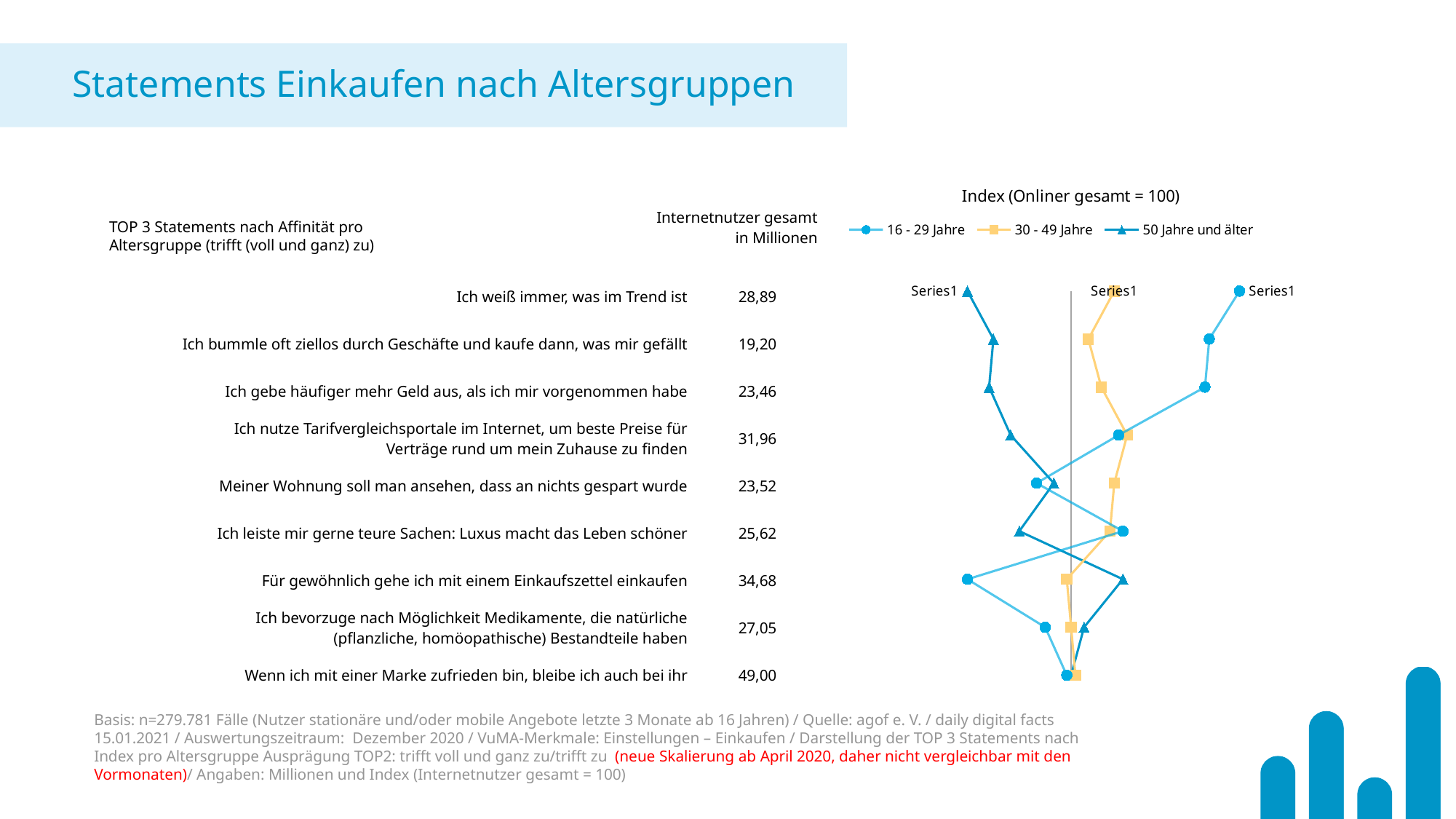
How many series does the chart legend list? 3 Which statement has the lowest value of 'Internetnutzer gesamt in Millionen'? Ich bummle oft ziellos durch Geschäfte und kaufe dann, was mir gefällt Is the index for 16 - 29 Jahre for 'Ich weiß immer, was im Trend ist' greater or less than 100? greater For 'Ich bummle oft ziellos durch Geschäfte und kaufe dann, was mir gefällt', which age group has the higher index: 16 - 29 Jahre or 50 Jahre und älter? 16 - 29 Jahre Which age groups are listed in the chart legend? 16 - 29 Jahre, 30 - 49 Jahre, 50 Jahre und älter Is the index for 16 - 29 Jahre for 'Für gewöhnlich gehe ich mit einem Einkaufszettel einkaufen' greater or less than 100? less For 'Für gewöhnlich gehe ich mit einem Einkaufszettel einkaufen', which age group has the higher index: 16 - 29 Jahre or 50 Jahre und älter? 50 Jahre und älter What type of chart is used to show the index values by age group? line chart How many statements (categories) are plotted in the chart? 9 Is the index for 50 Jahre und älter for 'Ich weiß immer, was im Trend ist' greater or less than 100? less What is the value of 'Internetnutzer gesamt in Millionen' for 'Wenn ich mit einer Marke zufrieden bin, bleibe ich auch bei ihr'? 49,00 What is the difference in 'Internetnutzer gesamt in Millionen' between 'Wenn ich mit einer Marke zufrieden bin, bleibe ich auch bei ihr' and 'Ich bummle oft ziellos durch Geschäfte und kaufe dann, was mir gefällt'? 29,80